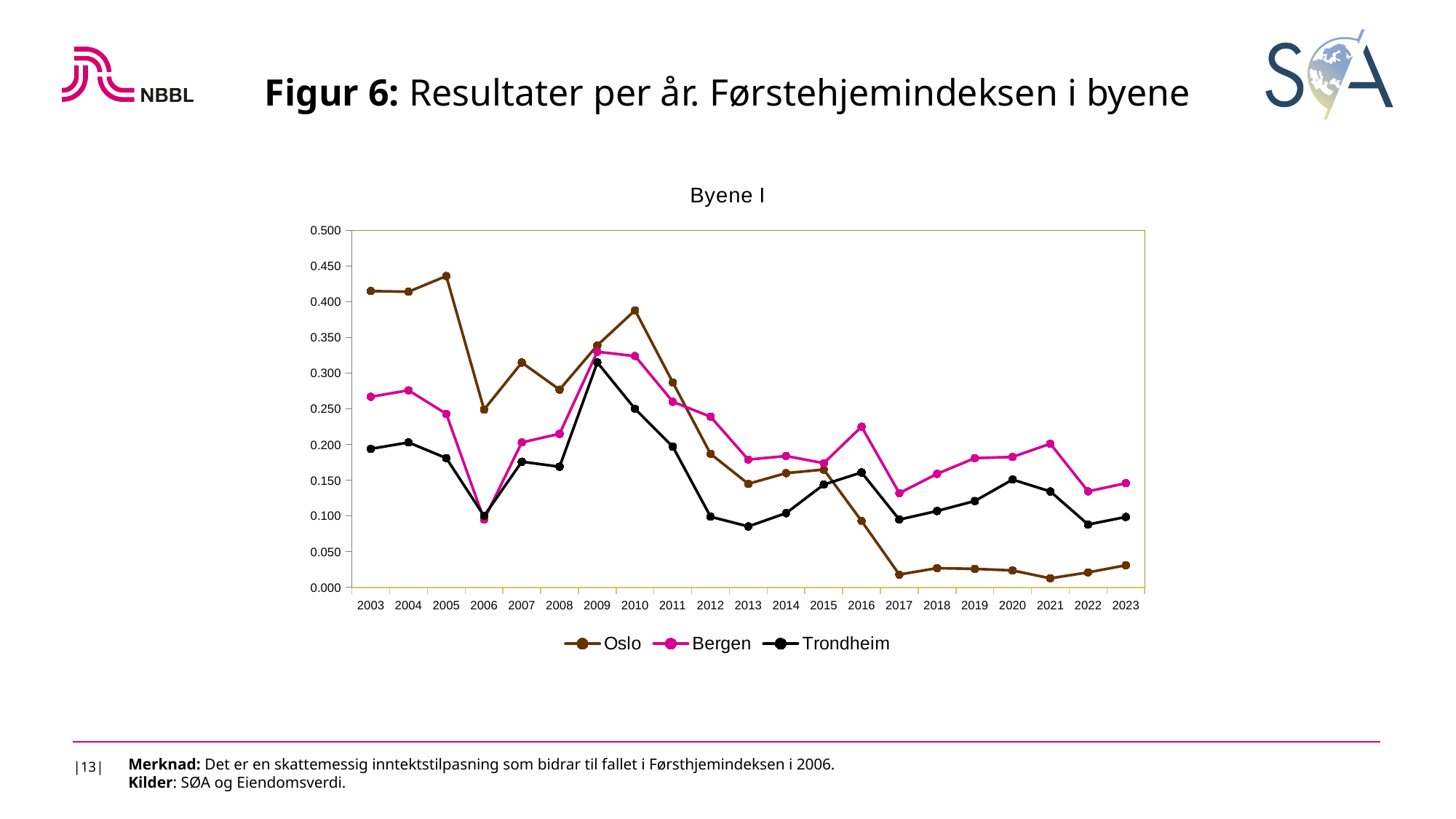
Is the value for Trondheim in 2013 greater or less than 0.100? less Which series is drawn in pink? Bergen In which year does Oslo reach its highest value? 2005 In 2003, which is larger, the value for Oslo or the value for Bergen? Oslo What kind of chart is shown on the slide? line chart Is the value for Oslo in 2017 greater or less than 0.050? less Is the value for Oslo in 2005 greater or less than 0.400? greater What is the title of the chart? Byene I How many years are plotted along the x axis? 21 In 2023, which series has the highest value? Bergen How many series does the legend list? 3